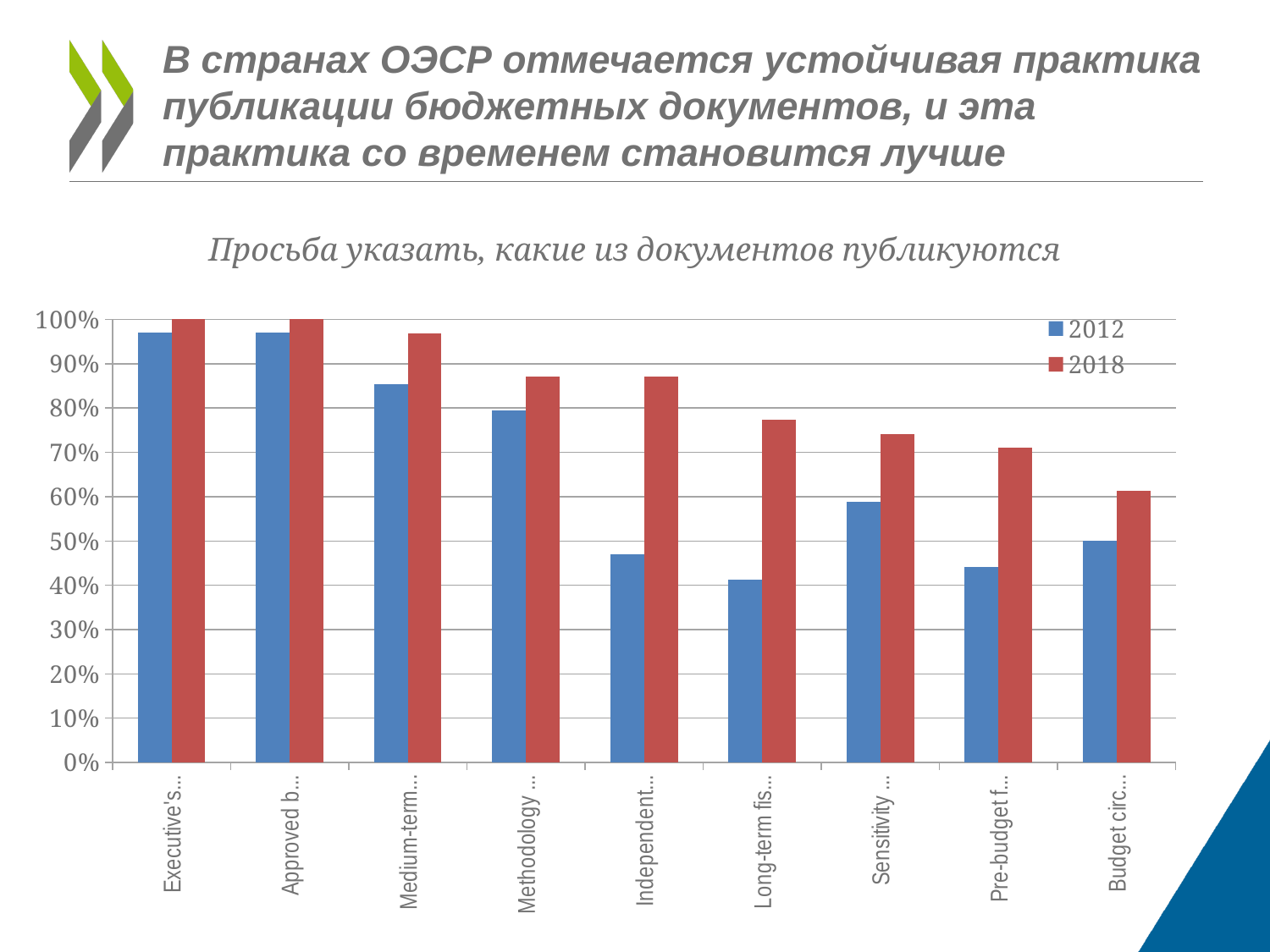
Is the 2012 value for 'Long-term fis...' greater or less than 50%? less Which category has the lowest 2018 value? Budget circ... What is the 2018 value for the 'Approved b...' category? 100% What is the 2018 value for the 'Executive's...' category? 100% How many series does the legend list? 2 What colour are the bars for the 2018 series? red Is the 2012 value for 'Sensitivity ...' greater or less than 50%? greater Is the 2018 value for 'Independent...' greater or less than 80%? greater How many categories are plotted along the x axis? 9 What kind of chart is shown on the slide? bar chart Do the 2018 values generally rise or fall from left to right along the x axis? fall For the 'Independent...' category, which series has the larger value, 2012 or 2018? 2018